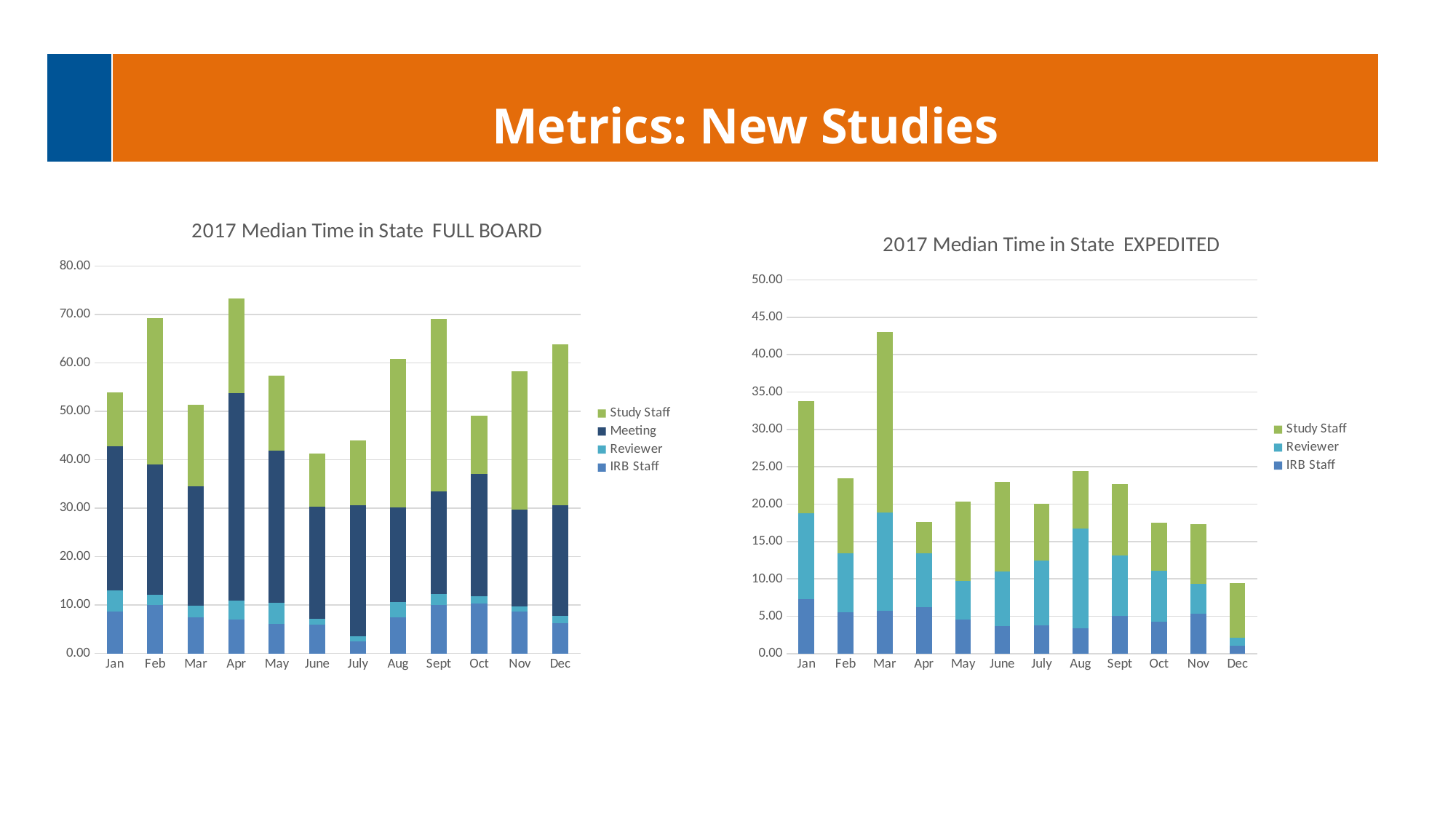
How many series does the legend of the 2017 Median Time in State EXPEDITED chart list? 3 In the 2017 Median Time in State EXPEDITED chart, is the total for Mar greater or less than 40.00? greater How many series does the legend of the 2017 Median Time in State FULL BOARD chart list? 4 In the 2017 Median Time in State FULL BOARD chart, is the total for Apr greater or less than 70.00? greater In the 2017 Median Time in State EXPEDITED chart, is the total for Dec greater or less than 10.00? less In the 2017 Median Time in State EXPEDITED chart, which month has the shortest stacked bar? Dec In the 2017 Median Time in State FULL BOARD chart, which month has the larger total, Feb or Mar? Feb What kind of chart is the 2017 Median Time in State EXPEDITED chart? Stacked bar chart In the 2017 Median Time in State EXPEDITED chart, which month has the larger total, Jan or Feb? Jan In the 2017 Median Time in State EXPEDITED chart, which month has the tallest stacked bar? Mar In the 2017 Median Time in State FULL BOARD chart, which month has the tallest stacked bar? Apr